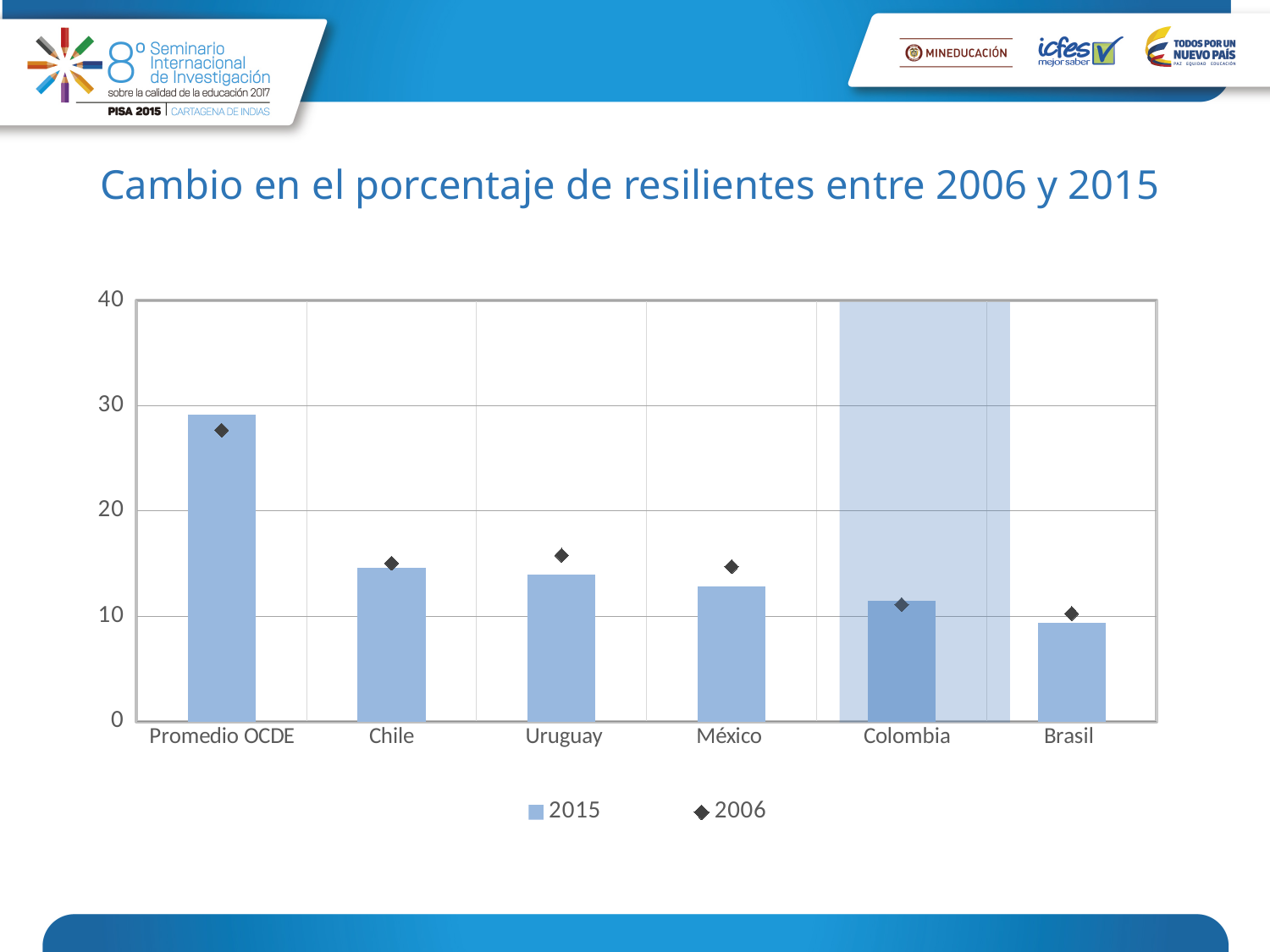
How many categories are shown on the x axis of the chart? 6 Which category has the highest 2015 bar? Promedio OCDE What kind of chart is shown on the slide? bar chart Is the 2015 value for Promedio OCDE greater or less than 20? greater Is the 2015 value for Brasil greater or less than 10? less What is the title of the slide? Cambio en el porcentaje de resilientes entre 2006 y 2015 Which is larger, the 2015 value for Promedio OCDE or the 2015 value for Chile? Promedio OCDE Do the 2015 bars rise or fall from left to right across the x axis? fall Which series is shown with diamond markers according to the legend? 2006 Is the 2006 value for Uruguay greater or less than 20? less Which category has the lowest 2015 bar? Brasil How many series does the legend list? 2